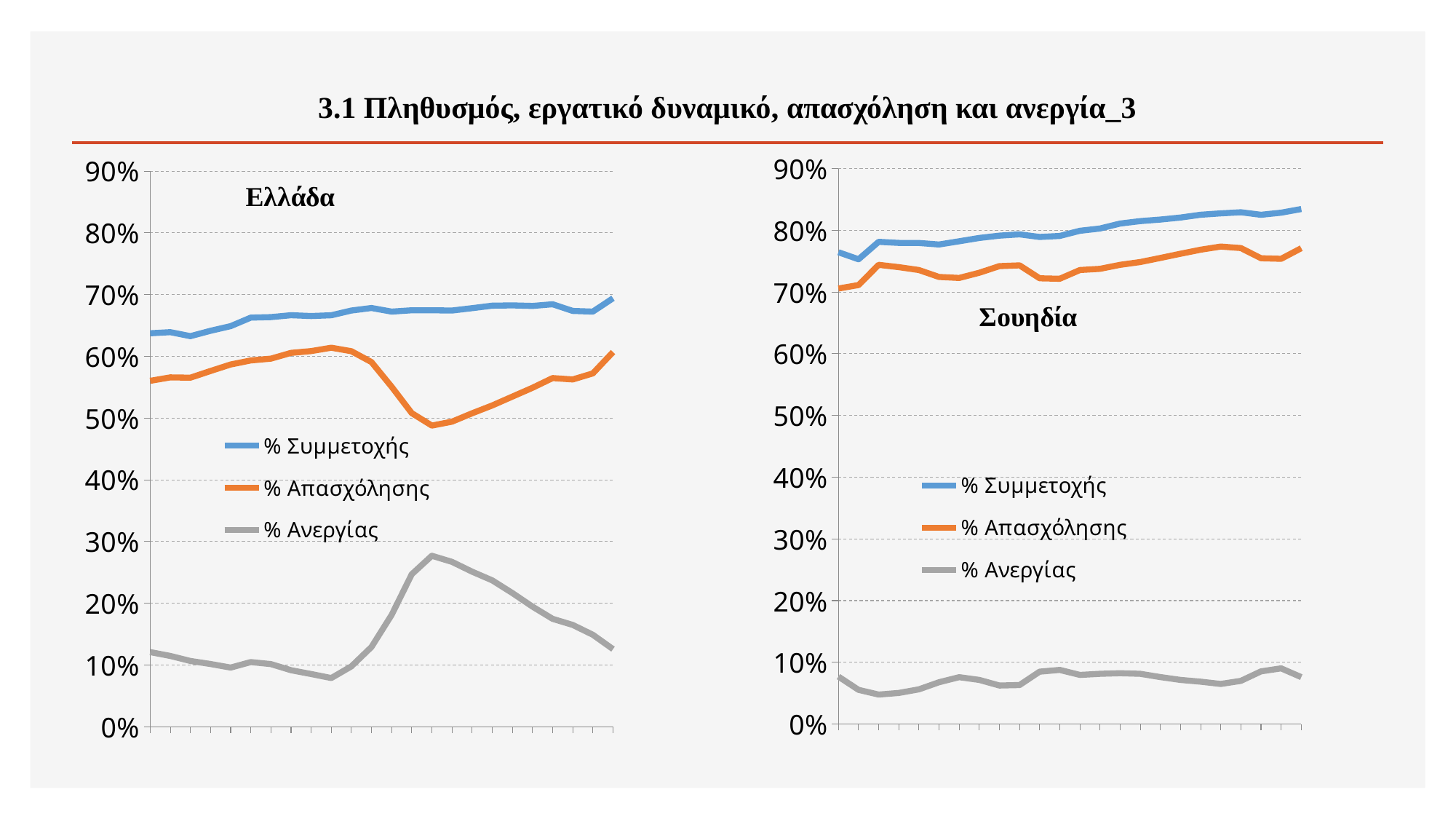
How many series does the legend of the Σουηδία chart list? 3 In the Σουηδία chart, is the first value of % Απασχόλησης greater or less than 60%? greater In the Ελλάδα chart, is the final value of % Συμμετοχής greater or less than 60%? greater What is the title of the slide? 3.1 Πληθυσμός, εργατικό δυναμικό, απασχόληση και ανεργία_3 In the Σουηδία chart, does % Συμμετοχής generally rise or fall along the x axis? rise In the Ελλάδα chart, which series has the highest values throughout? % Συμμετοχής In the Ελλάδα chart, is the peak value of % Ανεργίας greater or less than 20%? greater How many charts are shown on the slide? 2 What kind of chart is the Ελλάδα chart on the left? line chart Which chart shows the higher peak in % Ανεργίας, Ελλάδα or Σουηδία? Ελλάδα